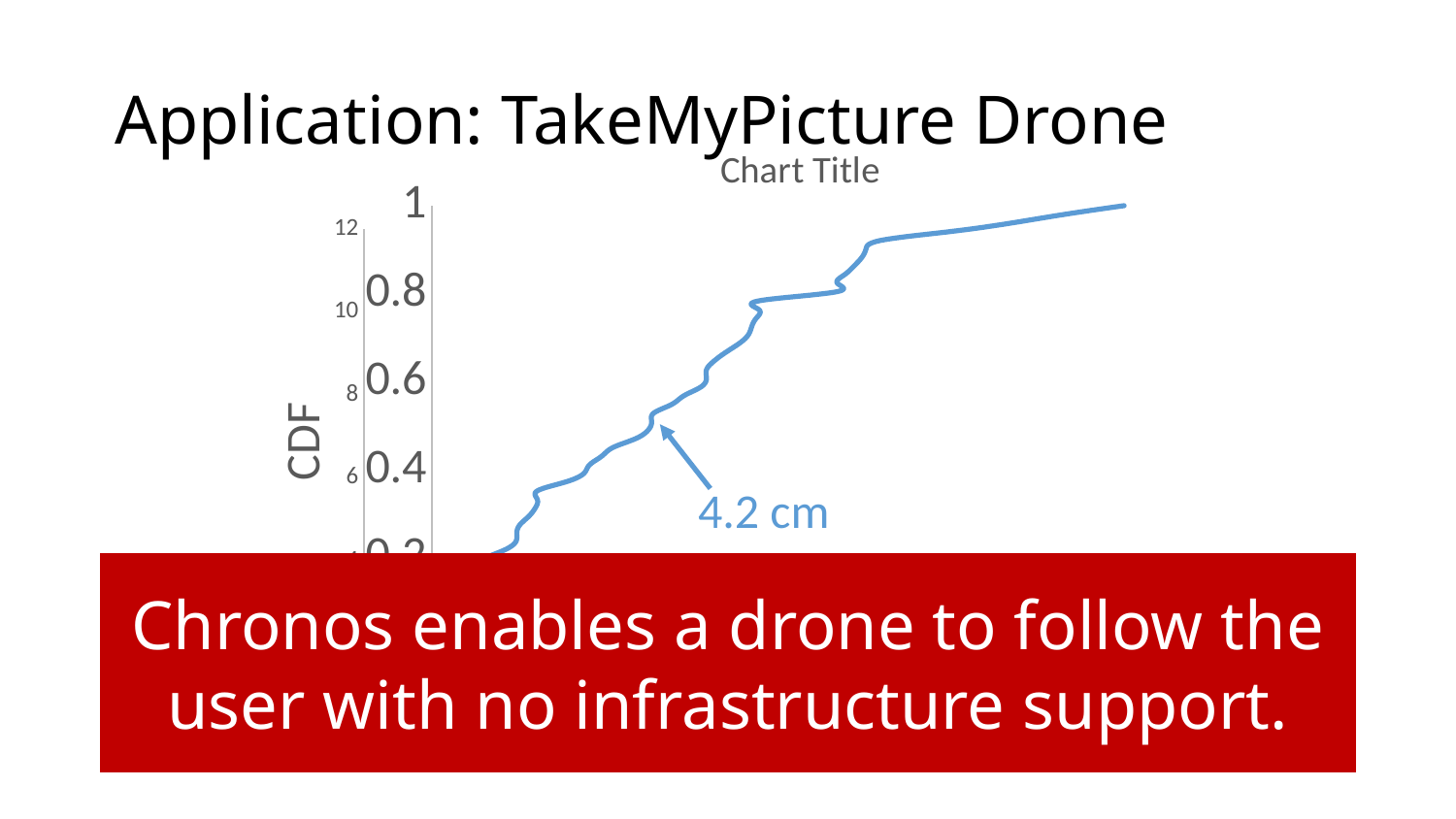
Do the values of the plotted line rise or fall from left to right along the x axis? rise Is the CDF value at the right-hand end of the plotted line greater or less than 0.8? greater Is the CDF value at the point annotated "4.2 cm" greater or less than 0.4? greater What value does the annotation with the arrow on the chart point out? 4.2 cm What is the highest tick value shown on the CDF axis? 1 Is the CDF value at the point annotated "4.2 cm" greater or less than 0.6? less What is the label on the vertical axis of the chart? CDF What kind of chart is shown on the slide? line chart What is the title printed above the chart? Chart Title